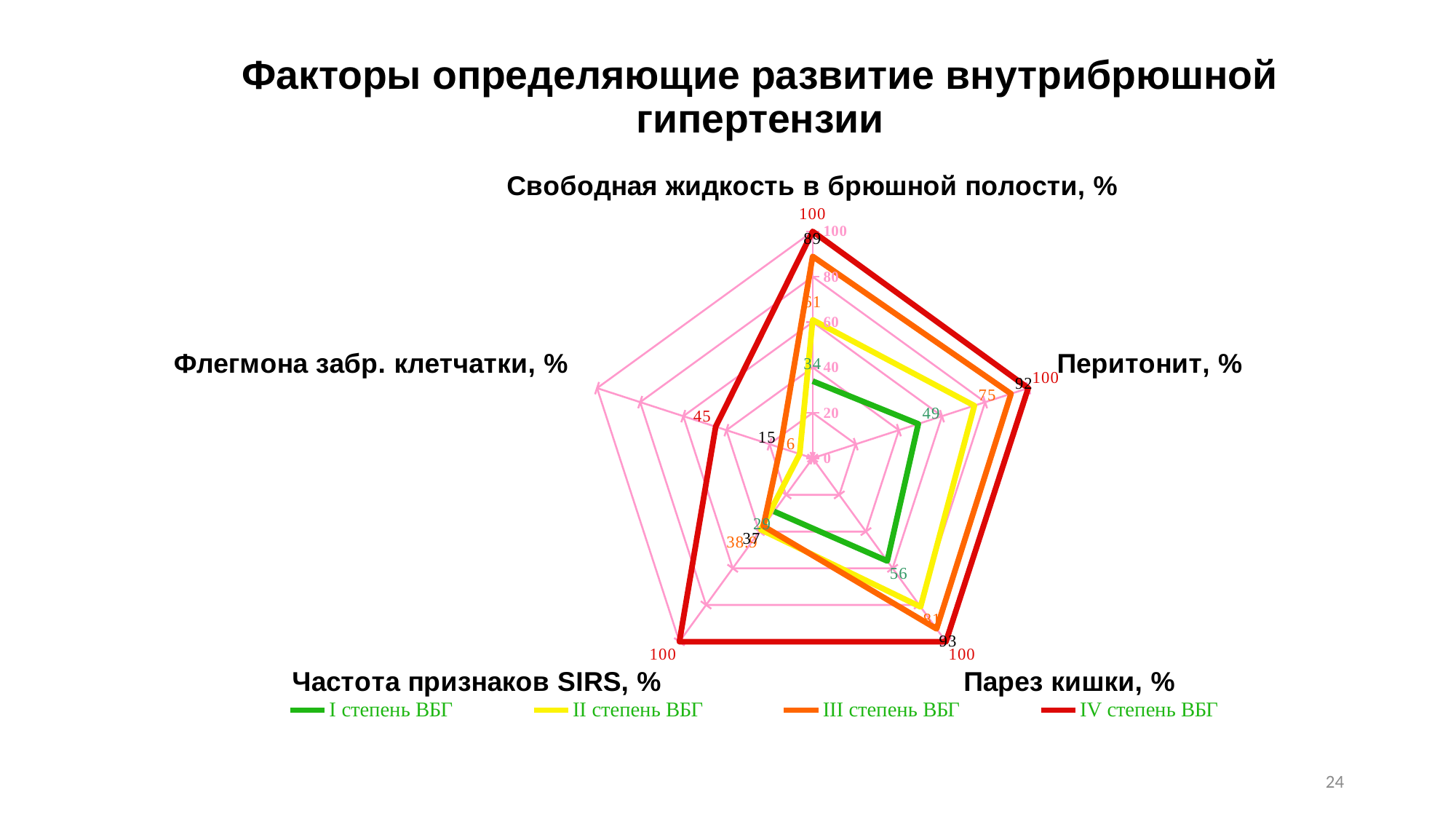
What kind of chart is shown on the slide? radar chart What is the value for I степень ВБГ on the Частота признаков SIRS, % axis? 29 How many axes (factors) does the radar chart have? 5 For I степень ВБГ, which is larger: the value on Перитонит, % or on Парез кишки, %? Парез кишки, % How many series does the legend list? 4 Which series has the lowest value on the Парез кишки, % axis? I степень ВБГ Which series has the highest value on the Перитонит, % axis? IV степень ВБГ What is the value for I степень ВБГ on the Свободная жидкость в брюшной полости, % axis? 34 What is the value for I степень ВБГ on the Парез кишки, % axis? 56 What is the value for IV степень ВБГ on the Перитонит, % axis? 100 What is the difference between IV степень ВБГ and I степень ВБГ on the Свободная жидкость в брюшной полости, % axis? 66 What is the value for IV степень ВБГ on the Флегмона забр. клетчатки, % axis? 45